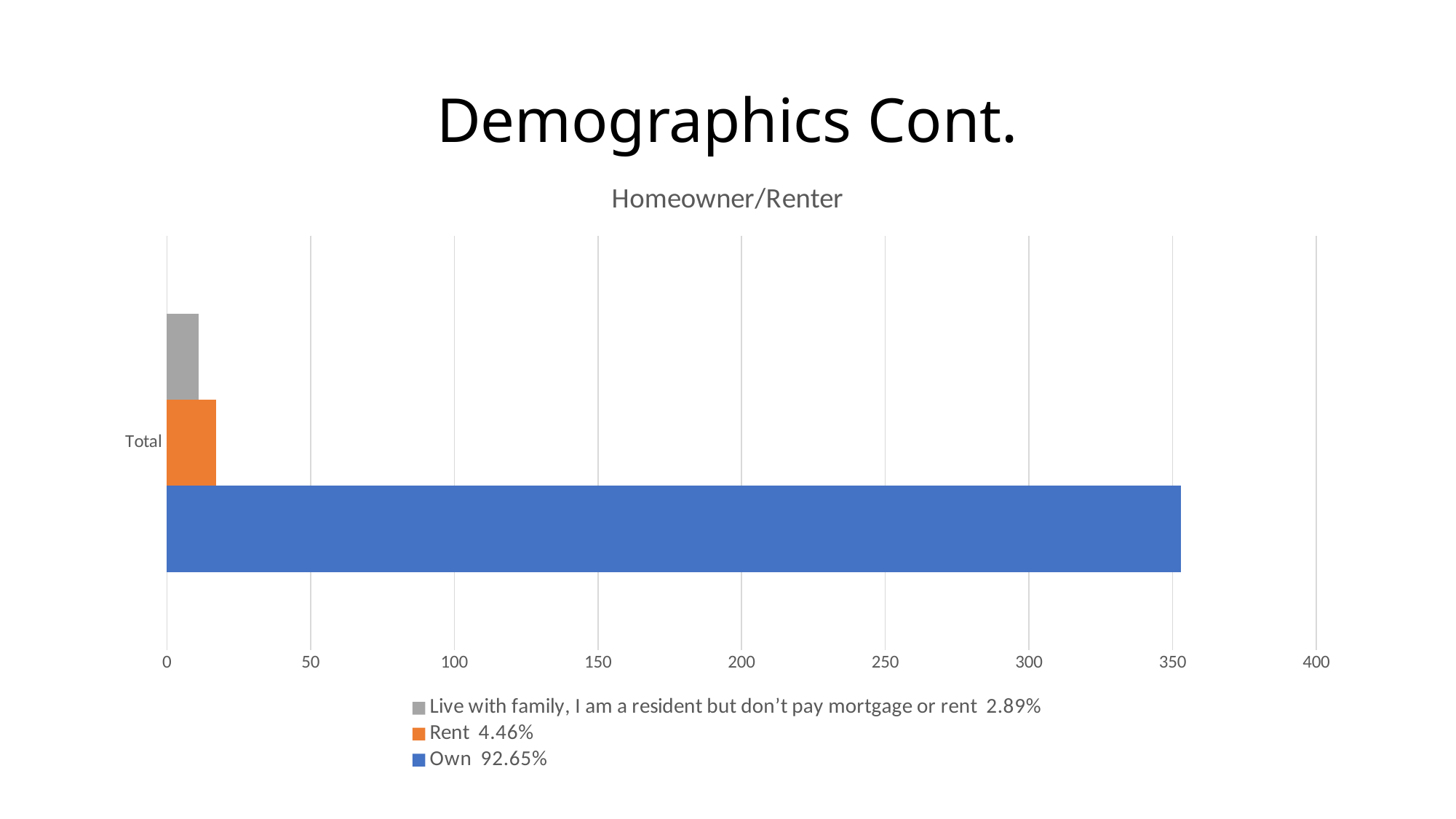
Is the value for Rent greater or less than 50? less Which bar is longer, Rent or Live with family, I am a resident but don't pay mortgage or rent? Rent How many series does the legend list? 3 What kind of chart is shown on the slide? bar chart Which series has the shortest bar? Live with family, I am a resident but don't pay mortgage or rent Which series has the longest bar? Own Is the value for Own greater or less than 300? greater What percentage is shown in the legend for Own? 92.65% What is the title of the chart? Homeowner/Renter What percentage is shown in the legend for Rent? 4.46% What is the label of the single category on the vertical axis? Total How many categories are plotted on the vertical axis? 1